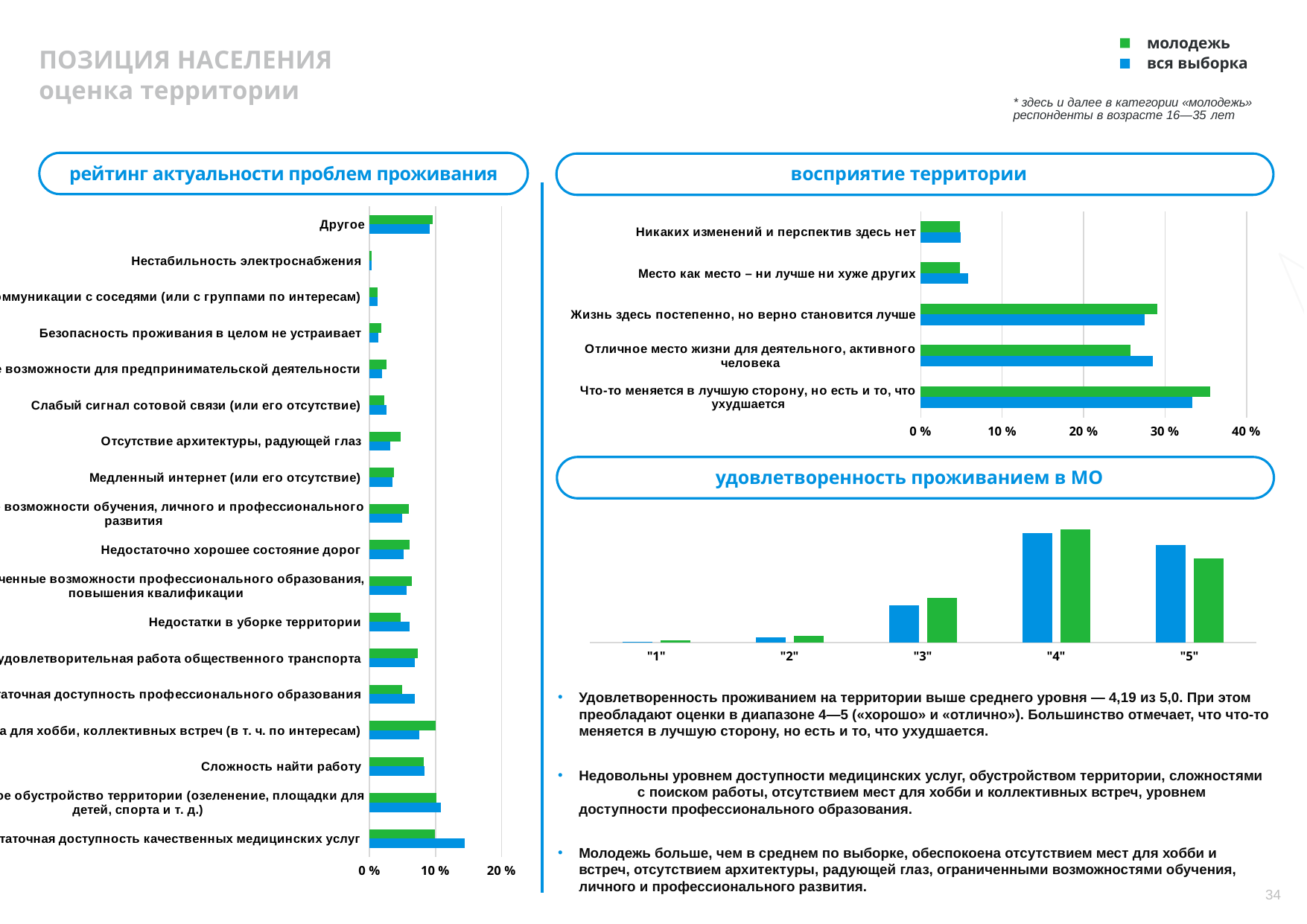
In the "рейтинг актуальности проблем проживания" chart, is the "молодежь" value for "Другое" greater or less than 20 %? less What kind of chart is the "рейтинг актуальности проблем проживания" chart? bar chart In the "рейтинг актуальности проблем проживания" chart, is the "вся выборка" value for "Сложность найти работу" greater or less than 10 %? less In the "восприятие территории" chart, for "Отличное место жизни для деятельного, активного человека", which series has the larger value: "молодежь" or "вся выборка"? вся выборка In the "удовлетворенность проживанием в МО" chart, for category "5", which series has the larger value: "молодежь" or "вся выборка"? вся выборка In the "удовлетворенность проживанием в МО" chart, which category has the highest bars? "4" How many series does the legend at the top right of the slide list? 2 In the "восприятие территории" chart, is the "молодежь" value for "Жизнь здесь постепенно, но верно становится лучше" greater or less than 20 %? greater In the "восприятие территории" chart, which category has the lowest values? Никаких изменений и перспектив здесь нет In the "восприятие территории" chart, which category has the highest values? Что-то меняется в лучшую сторону, но есть и то, что ухудшается How many categories does the "восприятие территории" chart show? 5 In the "рейтинг актуальности проблем проживания" chart, which category has the lowest values? Нестабильность электроснабжения